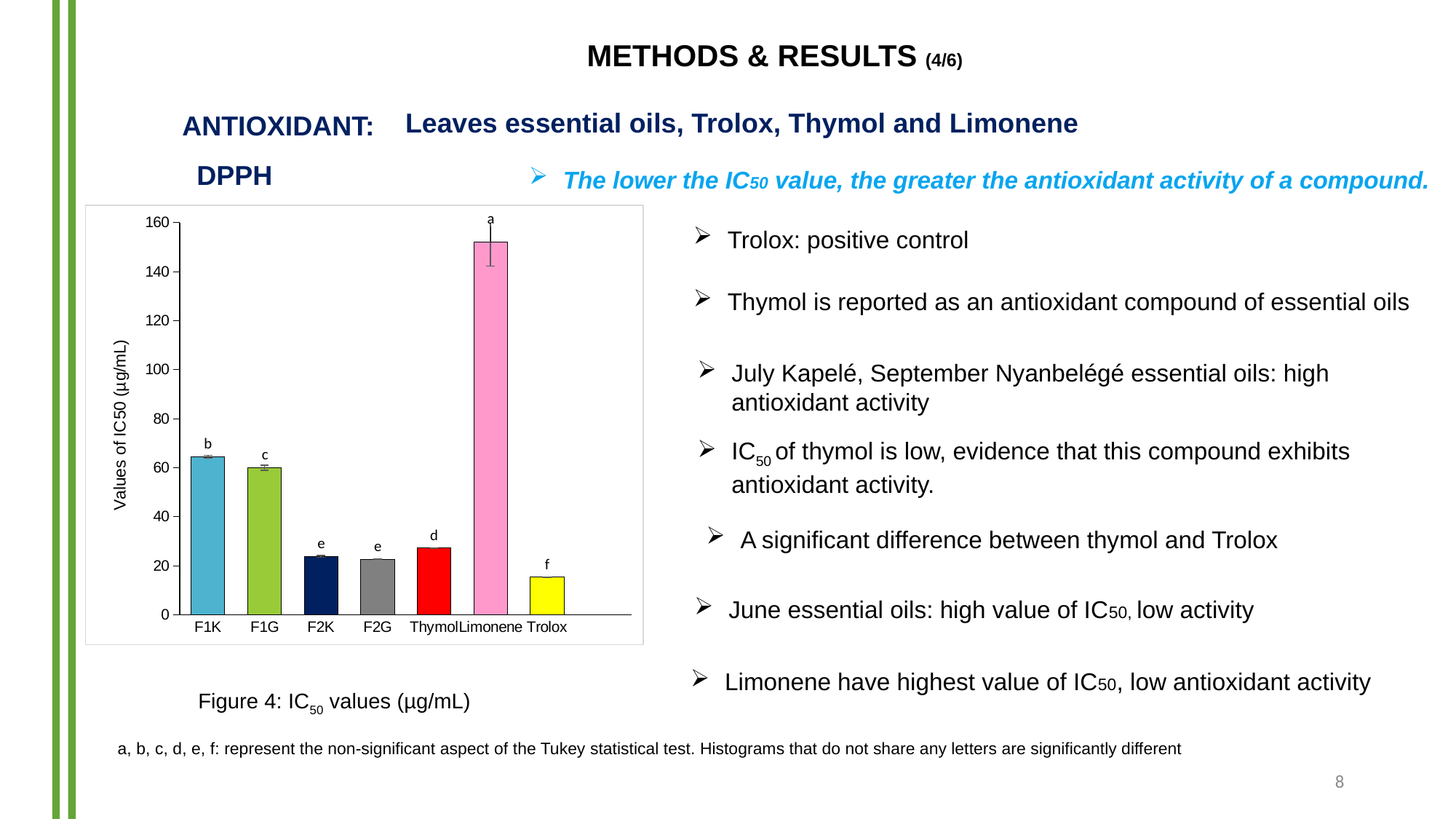
Which has the larger IC50 value, F1K or F2K? F1K Which has the larger IC50 value, Thymol or Trolox? Thymol Is the value for Thymol greater or less than 40? less Is the value for F2K greater or less than 20? greater Which category has the highest IC50 value in the chart? Limonene How many categories are plotted on the x axis of the chart? 7 Is the value for Limonene greater or less than 140? greater What is the label of the y axis of the chart? Values of IC50 (µg/mL) Which letter is printed above the Limonene bar? a Which category has the lowest IC50 value in the chart? Trolox What kind of chart is shown on the slide? bar chart